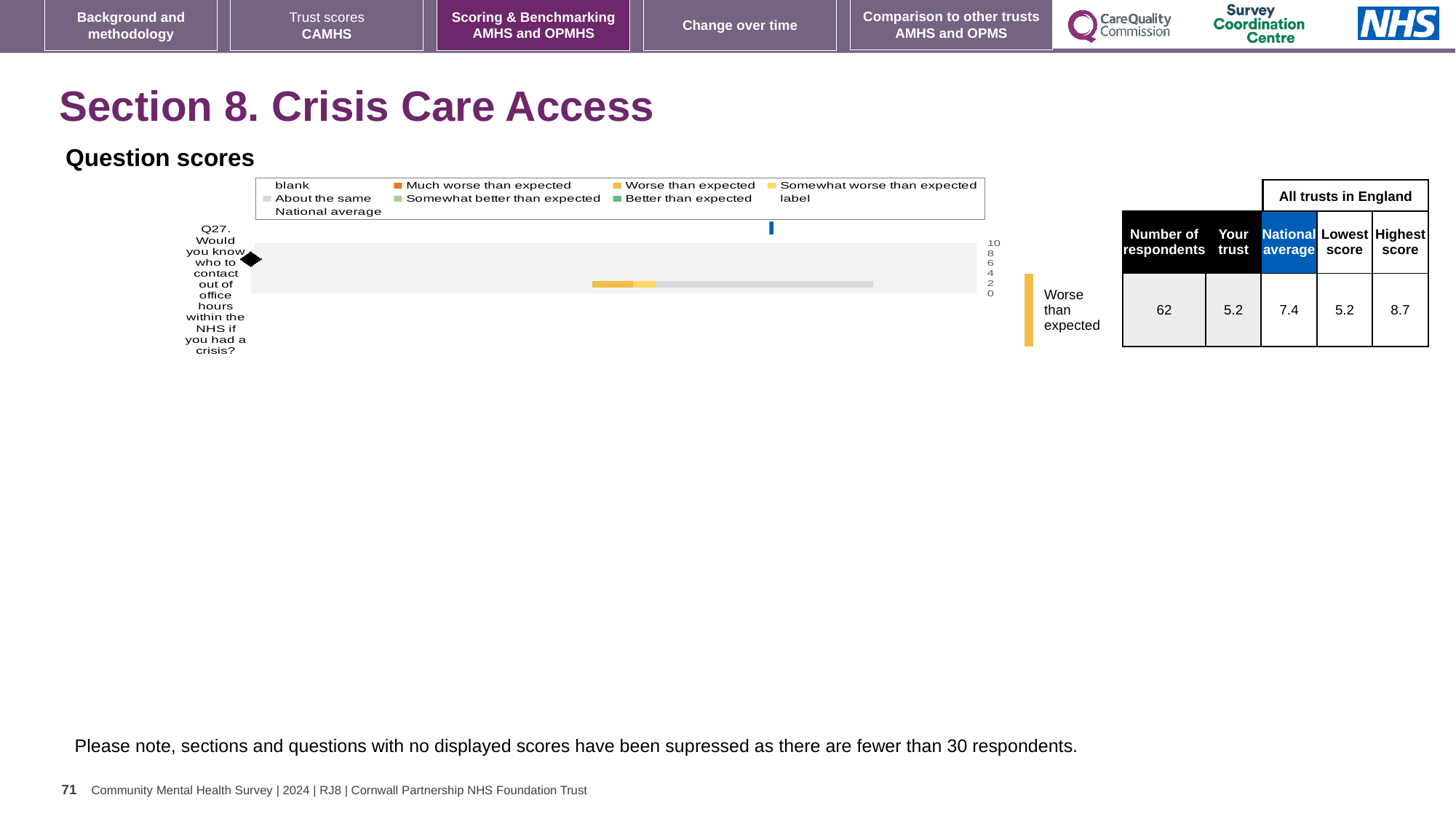
Which is larger for Q27, the trust's score or the national average? national average What is the highest score among all trusts in England for Q27? 8.7 What kind of chart is shown under 'Question scores'? bar chart Which question is plotted in the Question scores chart? Q27. Would you know who to contact out of office hours within the NHS if you had a crisis? Which colour in the legend represents 'Much worse than expected'? orange How many questions are plotted in the Question scores chart? 1 What benchmark category is shown next to the bar for Q27? Worse than expected What is the difference between the national average and the trust's score for Q27? 2.2 What is the 'Your trust' score for Q27? 5.2 How many respondents answered Q27? 62 What is the national average score for Q27? 7.4 What is the lowest score among all trusts in England for Q27? 5.2